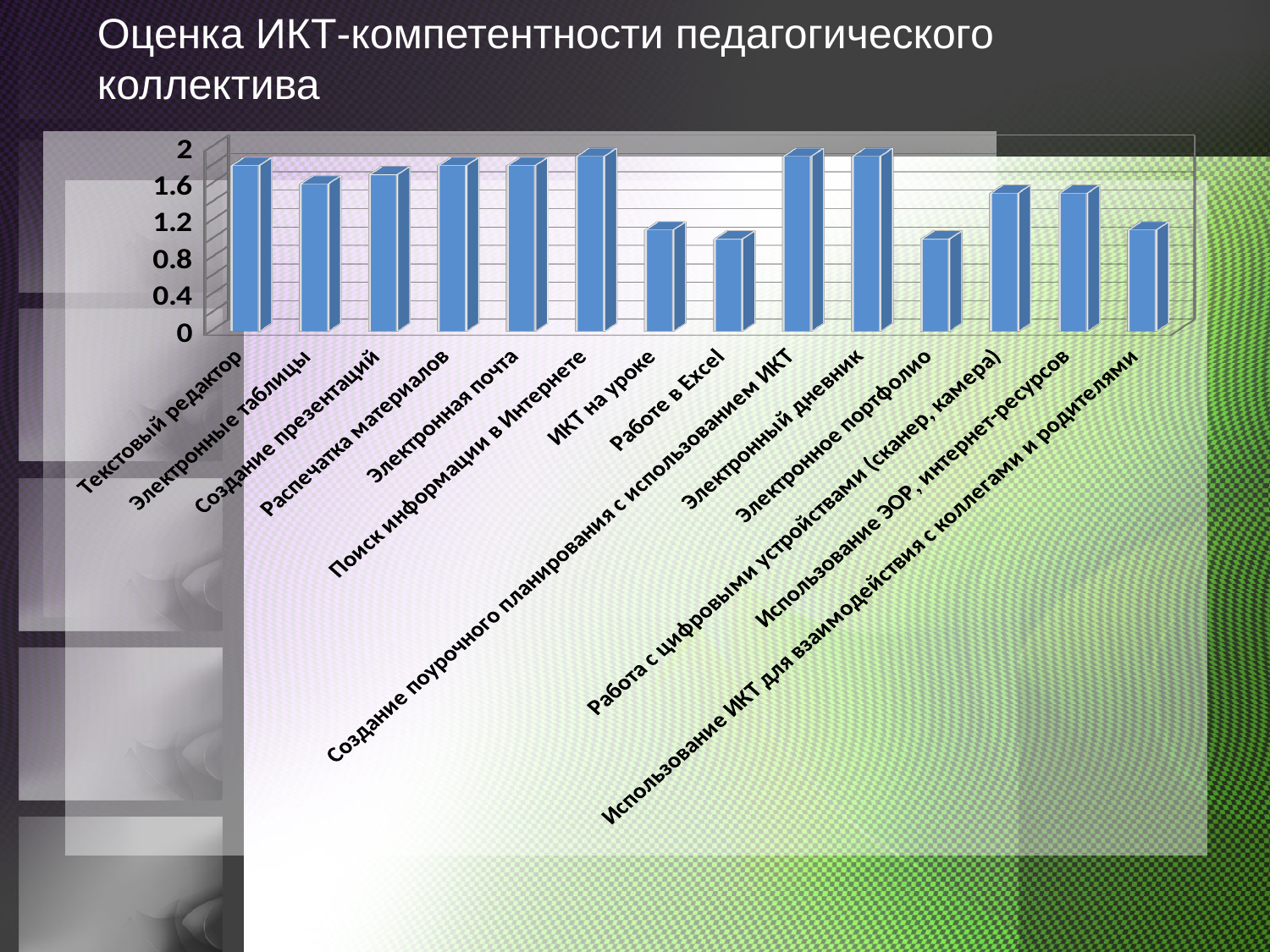
What kind of chart is shown on the slide? Bar chart Is the value for Работа с цифровыми устройствами (сканер, камера) greater or less than 1.2? greater Is the value for Текстовый редактор greater or less than 1.6? greater How many categories are plotted on the chart? 14 Which is larger, the value for Текстовый редактор or the value for Работе в Excel? Текстовый редактор Is the value for Электронные таблицы greater or less than 1.2? greater What is the title of the slide containing the chart? Оценка ИКТ-компетентности педагогического коллектива Which is larger, the value for Электронный дневник or the value for Электронное портфолио? Электронный дневник What is the highest tick value shown on the vertical axis? 2